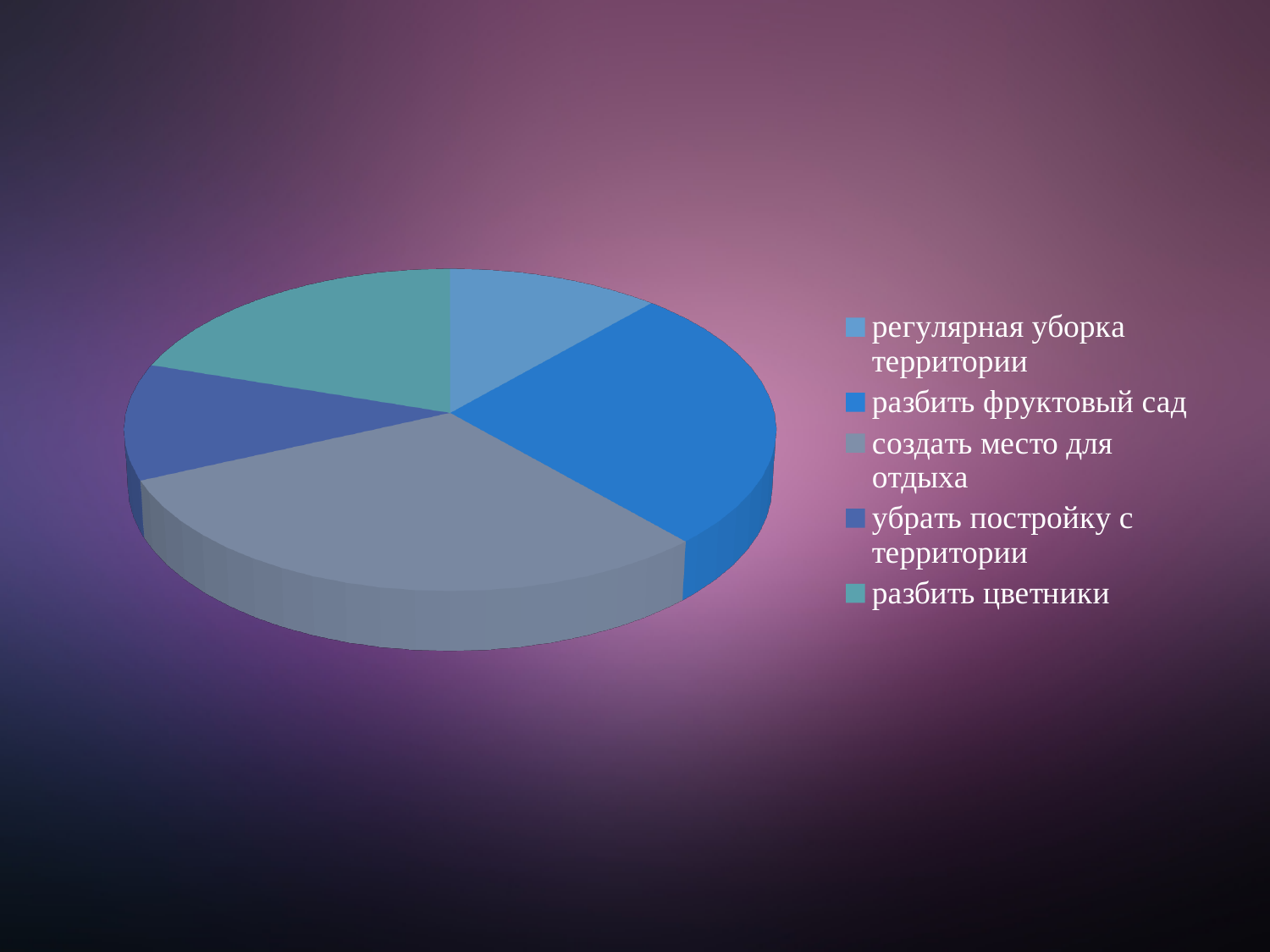
What kind of chart is shown on the slide? pie chart How many slices does the pie chart have? 5 Which slice is larger: создать место для отдыха or разбить фруктовый сад? создать место для отдыха Which category has the largest slice of the pie? создать место для отдыха Which legend entry is listed first in the legend? регулярная уборка территории Which slice is larger: разбить цветники or убрать постройку с территории? разбить цветники Which legend entry is shown in grey? создать место для отдыха How many entries does the legend list? 5 Which slice is larger: разбить фруктовый сад or регулярная уборка территории? разбить фруктовый сад